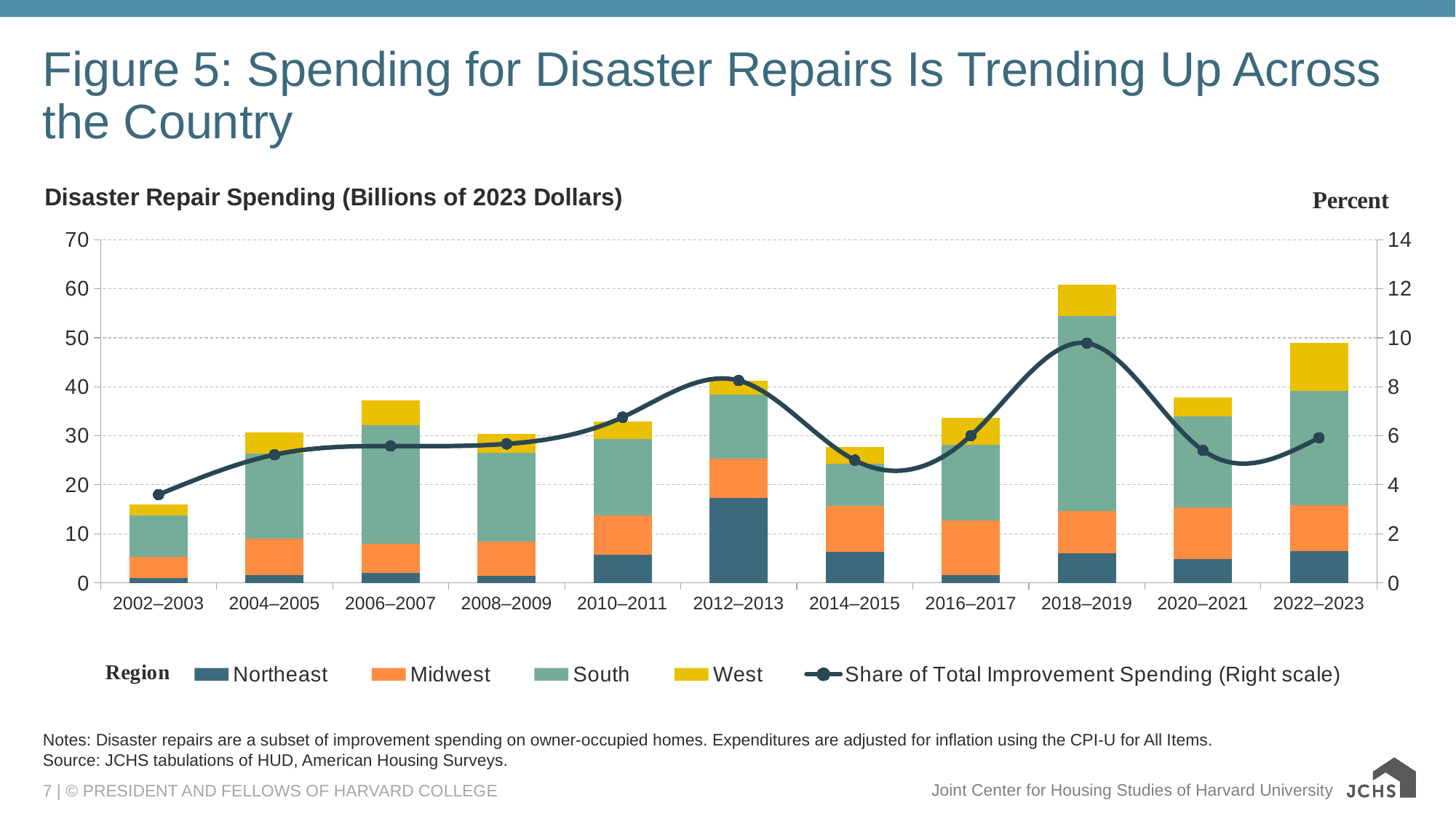
Is total disaster repair spending in 2022–2023 higher or lower than in 2002–2003? higher Which period has the larger Northeast segment, 2010–2011 or 2012–2013? 2012–2013 What kind of chart is shown on the slide? A stacked bar chart with a line overlay Is the Share of Total Improvement Spending for 2018–2019 greater or less than 8 percent? greater Is the total disaster repair spending for 2002–2003 greater or less than 20 billion dollars? less How many series does the legend list? 5 Which period has the highest total disaster repair spending? 2018–2019 In which period does the Share of Total Improvement Spending line reach its highest point? 2018–2019 Is the total disaster repair spending for 2018–2019 greater or less than 50 billion dollars? greater What is the label of the right-hand vertical axis? Percent How many two-year periods are shown on the x axis? 11 Which period has the lowest total disaster repair spending? 2002–2003